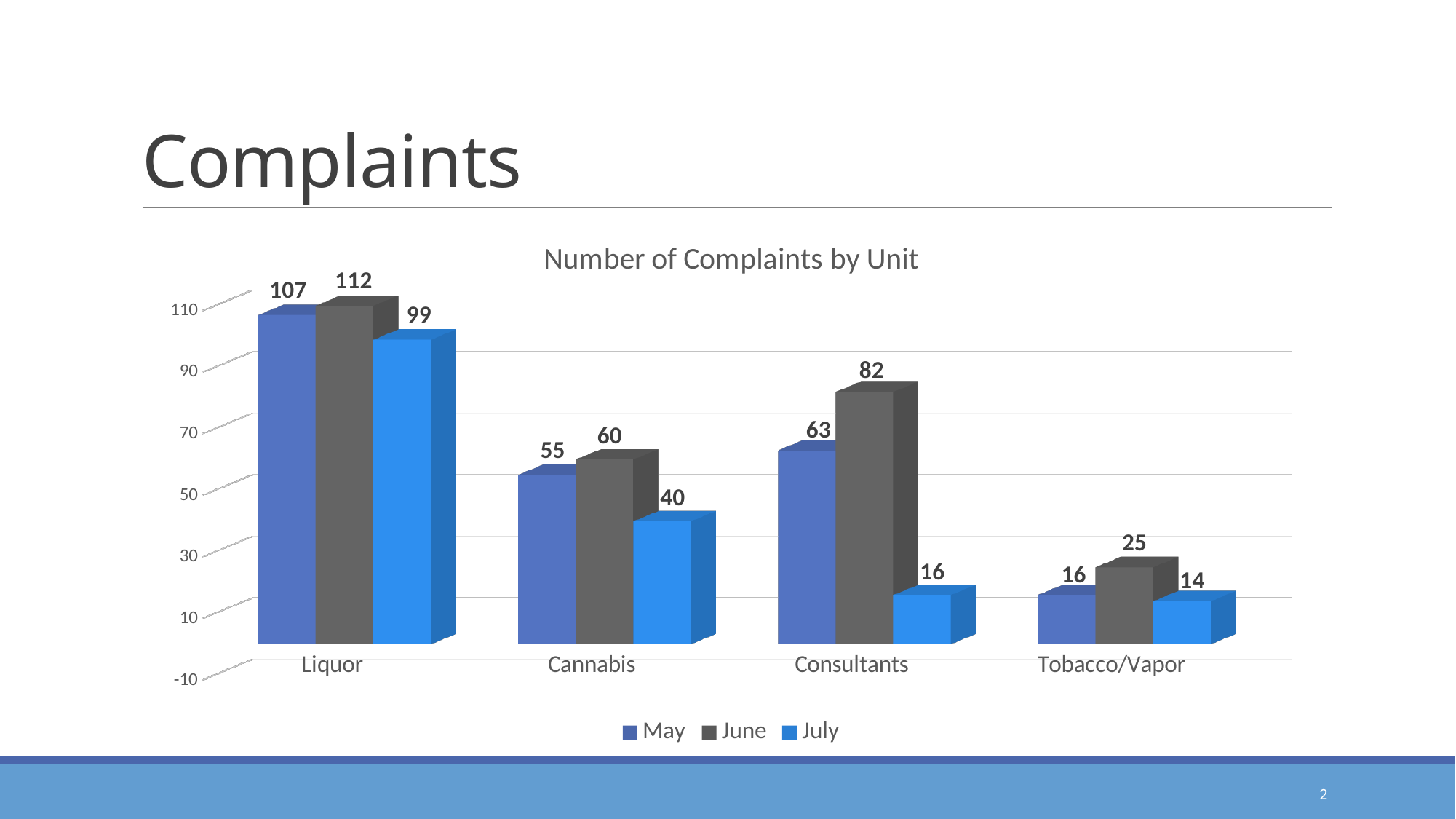
What is the title of the chart? Number of Complaints by Unit What kind of chart is shown on the slide? Bar chart How many units are shown on the x axis? 4 How many series does the legend list? 3 Which unit has the highest number of complaints in June? Liquor What is the number of complaints for Consultants in July? 16 What is the number of complaints for Liquor in June? 112 What is the number of complaints for Tobacco/Vapor in May? 16 What is the difference between the June and July complaints for Consultants? 66 Which unit has the lowest number of complaints in July? Tobacco/Vapor Which is larger, the May value for Cannabis or the May value for Consultants? Consultants Is the value for Cannabis in July greater or less than 50? less